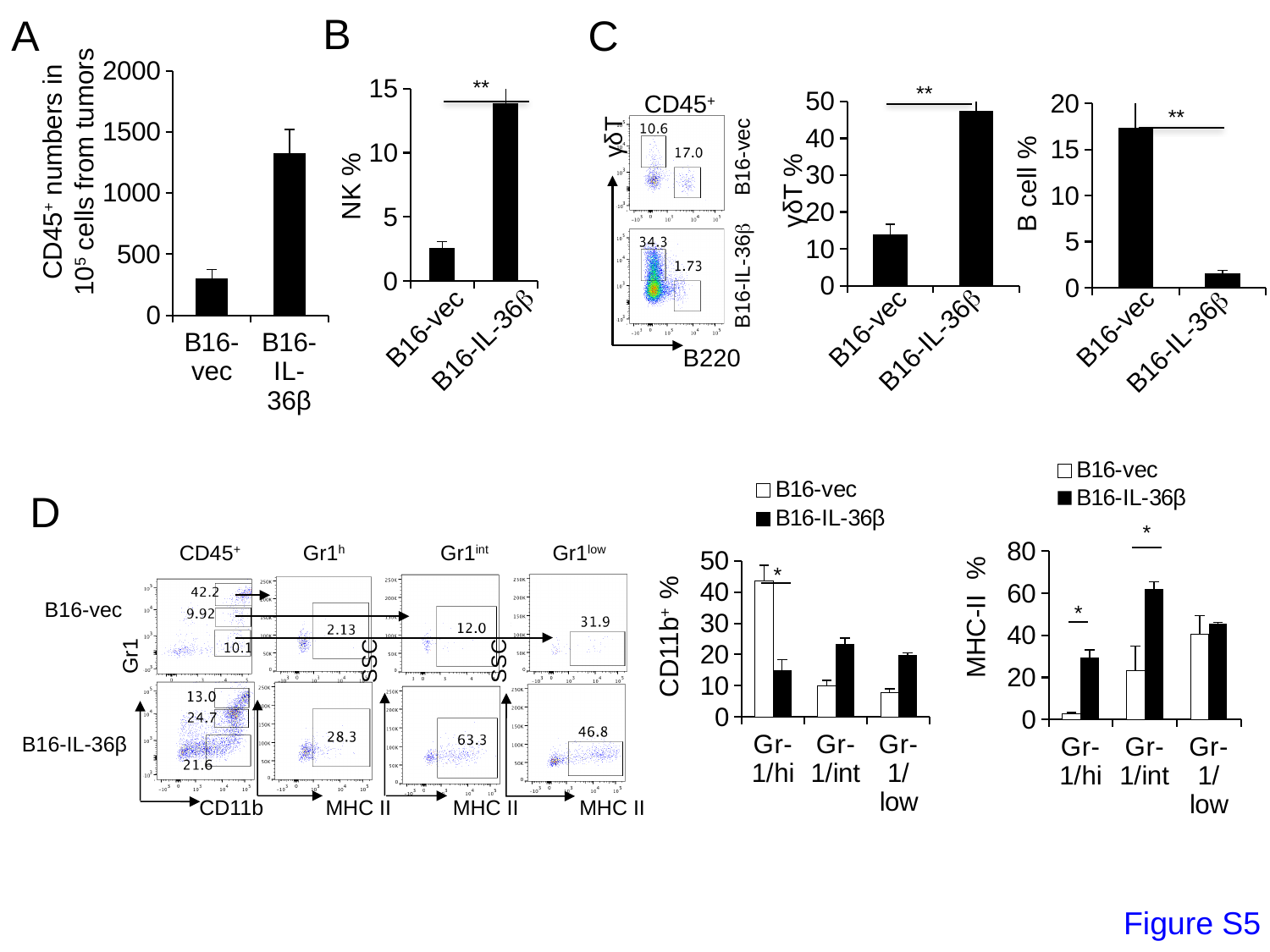
In panel A (CD45+ numbers in 10^5 cells from tumors), is the value for B16-IL-36β greater or less than 1000? greater In the MHC-II % chart of panel D, which category has the highest value for B16-IL-36β? Gr-1/int In the CD11b+ % chart of panel D, how many categories are shown on the x axis? 3 In panel A (CD45+ numbers in 10^5 cells from tumors), is the value for B16-vec greater or less than 500? less What kind of chart is the MHC-II % chart in panel D? bar chart In the CD11b+ % chart of panel D, how many series does the legend list? 2 In panel B (NK %), is the value for B16-vec greater or less than 5? less In the B cell % chart of panel C, which group has the lower value? B16-IL-36β In the CD11b+ % chart of panel D, which category has the highest value for B16-vec? Gr-1/hi In panel A (CD45+ numbers in 10^5 cells from tumors), which group has the higher value, B16-vec or B16-IL-36β? B16-IL-36β